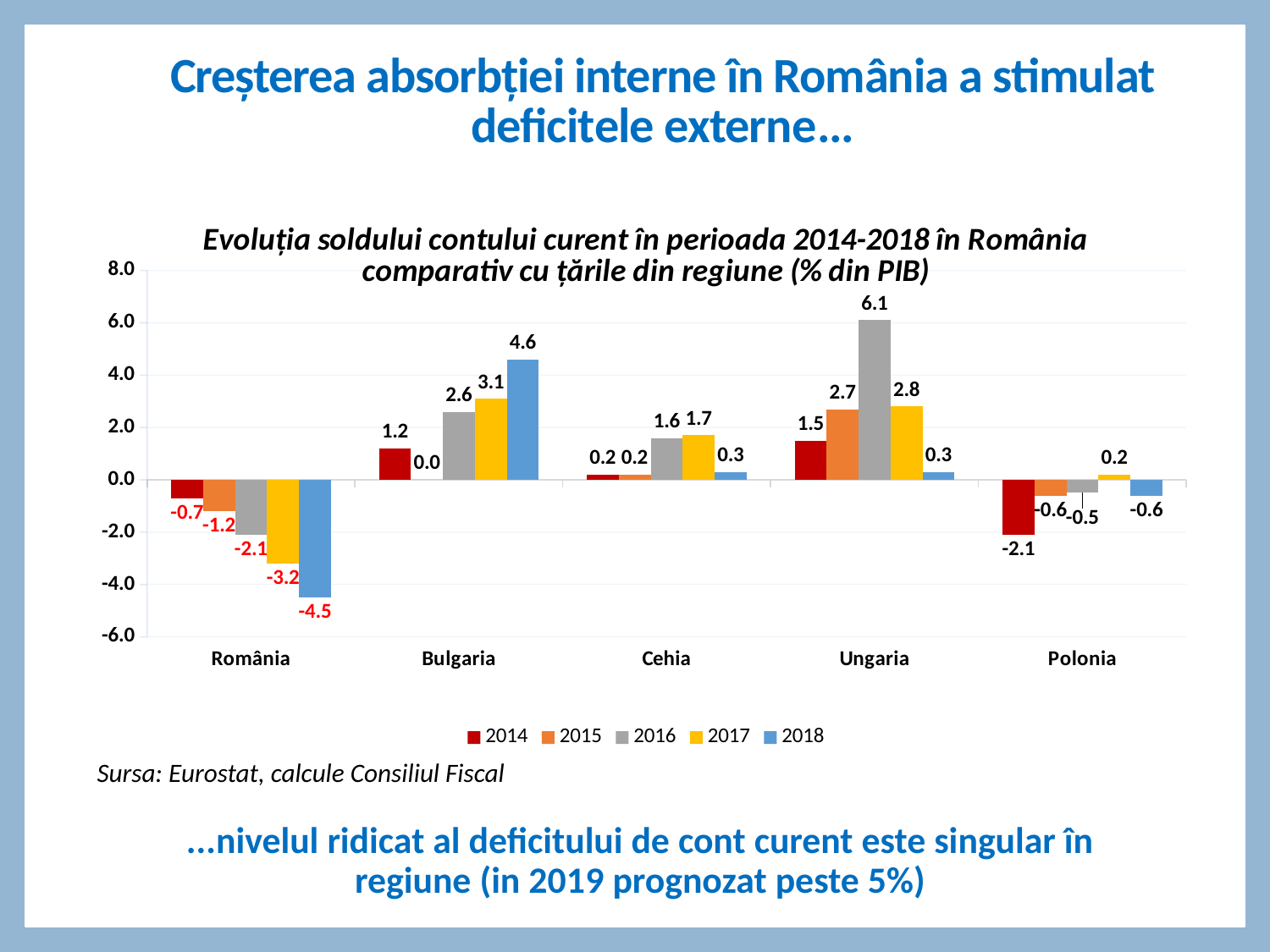
How many series does the legend list? 5 What is the value for Ungaria in 2016? 6.1 What kind of chart is shown on the slide? Bar chart How many countries are shown on the x axis? 5 What is the value for Bulgaria in 2015? 0.0 What is the value for Polonia in 2014? -2.1 Which country has the highest value in 2018? Bulgaria Which country has the lowest value in 2017? România Which is larger: Cehia's 2017 value or Ungaria's 2017 value? Ungaria's 2017 value Do România's values rise or fall from 2014 to 2018? Fall What is the difference between Bulgaria's 2018 value and România's 2018 value? 9.1 What is the value for România in 2018? -4.5